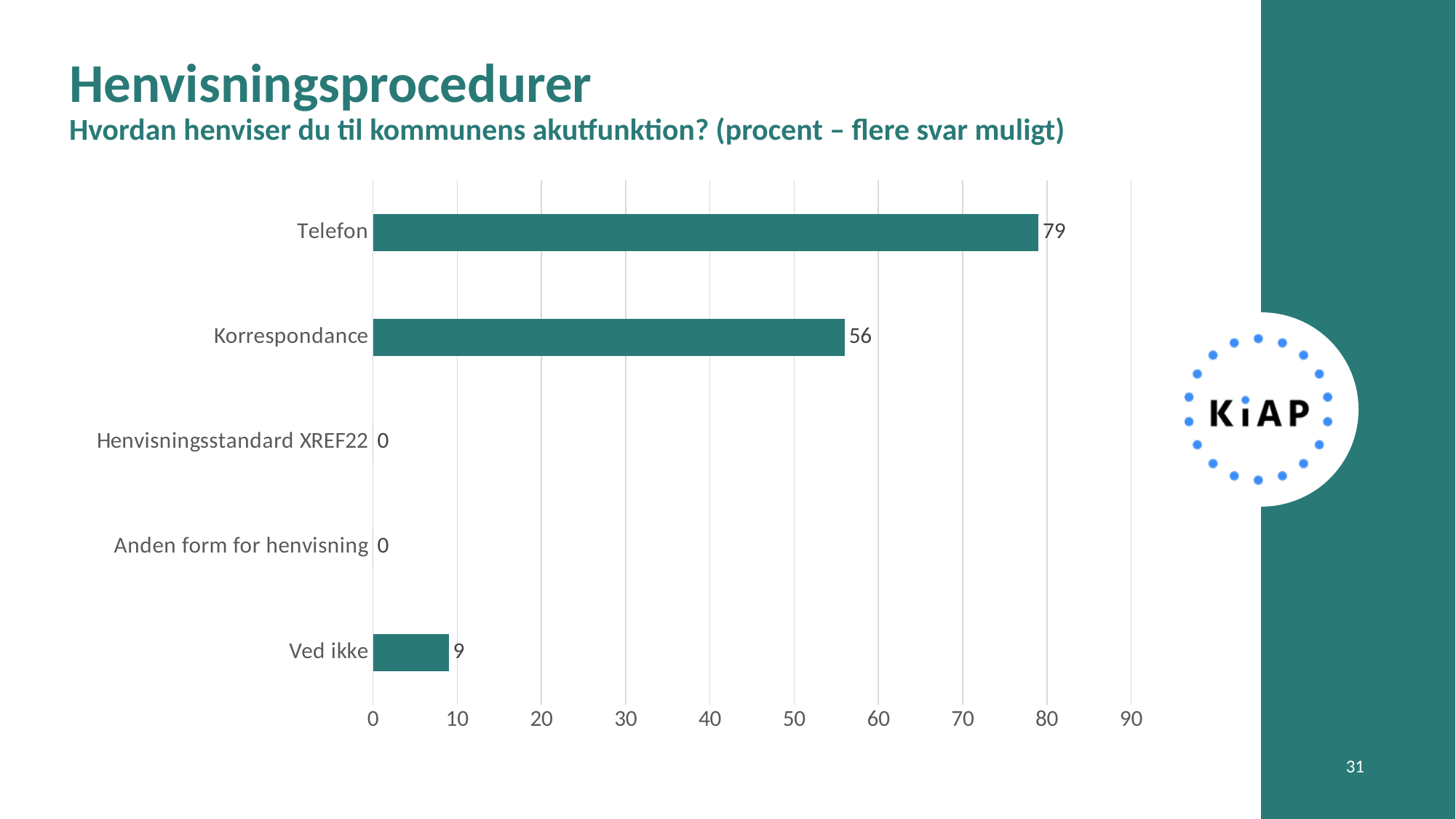
How many categories have a value of 0? 2 What is the value for Ved ikke? 9 Is the value for Telefon greater or less than 70? greater What is the value for Korrespondance? 56 What is the value for Henvisningsstandard XREF22? 0 Which category has the highest value? Telefon How many categories are shown in the chart? 5 What is the value for Telefon? 79 What is the title of the slide? Henvisningsprocedurer Which is larger, the value for Korrespondance or the value for Ved ikke? Korrespondance What is the difference between the values for Telefon and Korrespondance? 23 What kind of chart is shown on the slide? bar chart